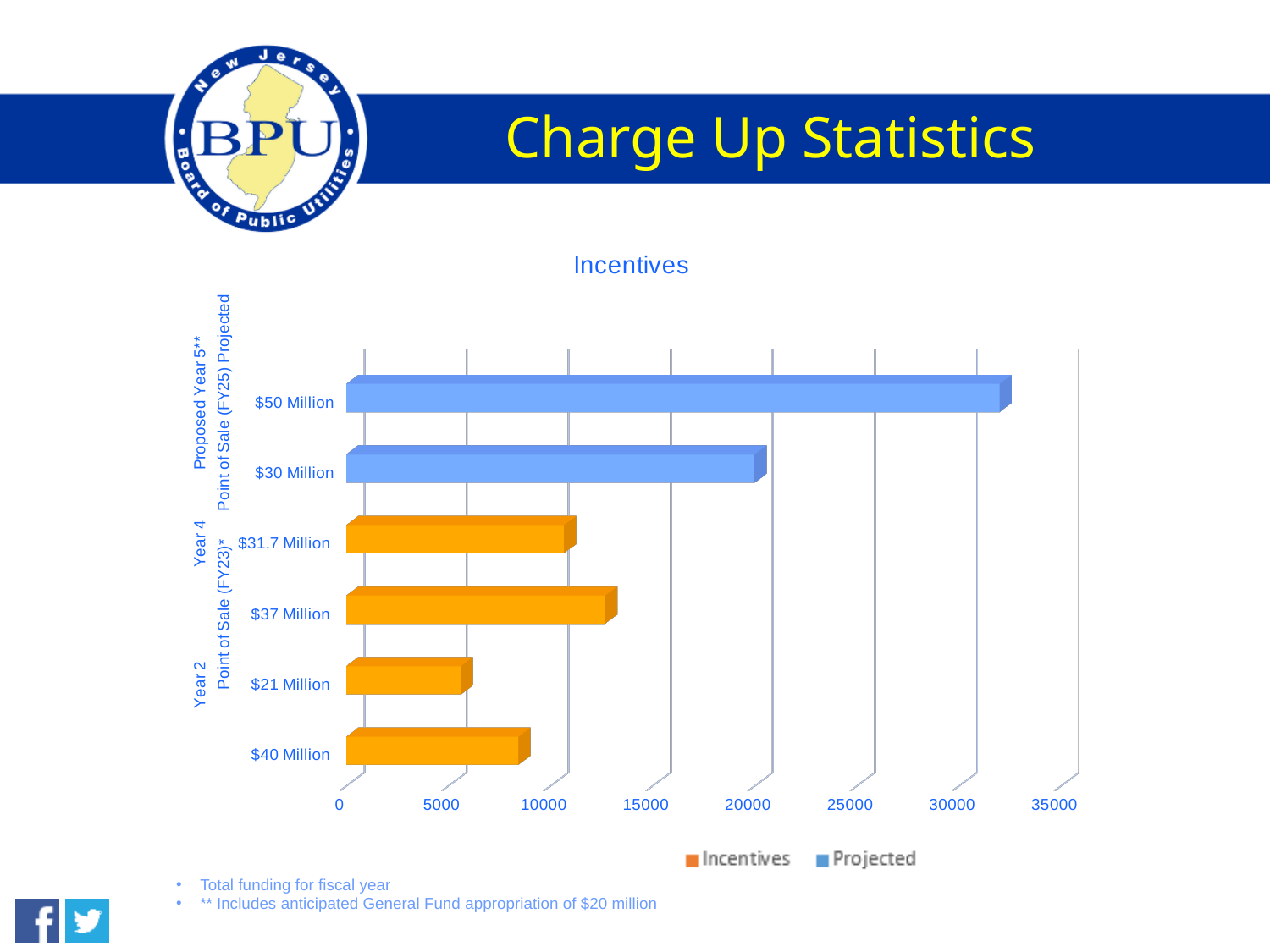
Is the value for $40 Million greater or less than 10000? less Which has the larger value, $37 Million or $31.7 Million? $37 Million Which category has the longest bar? $50 Million Which category has the shortest bar? $21 Million What is the title of the chart? Incentives Which series is shown in blue according to the legend? Projected What kind of chart is shown on the slide? bar chart How many categories are plotted on the chart? 6 Is the value for $50 Million greater or less than 30000? greater How many series does the legend list? 2 Is the value for $37 Million greater or less than 10000? greater